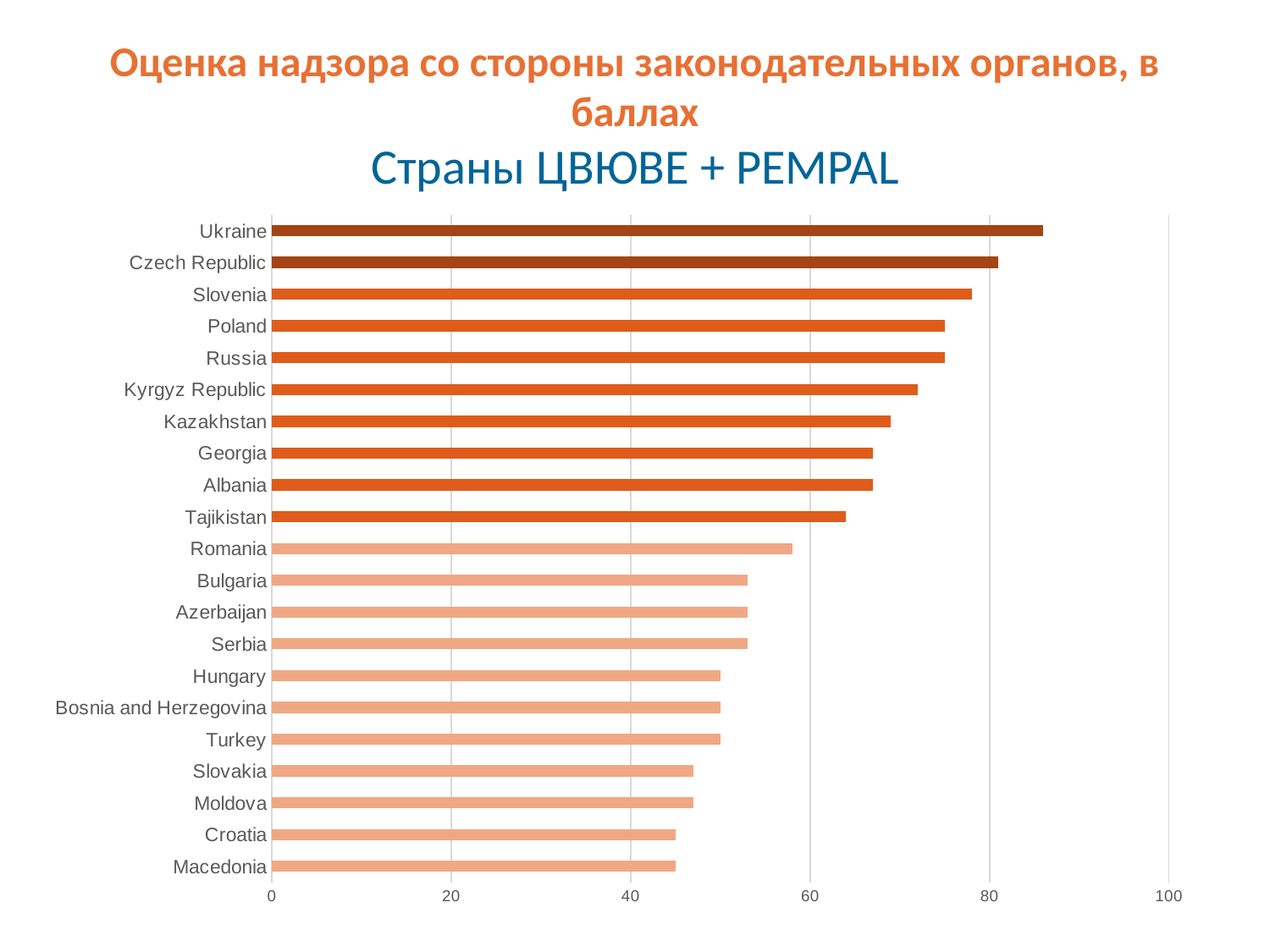
Which has a larger value, Slovenia or Romania? Slovenia Which has a larger value, Ukraine or Czech Republic? Ukraine Is the value for Ukraine greater or less than 80? greater Is the value for Poland greater or less than 80? less Which country has the highest value in the chart? Ukraine How many countries are shown in the chart? 21 What kind of chart is shown on the slide? bar chart Is the value for Tajikistan greater or less than 60? greater Which has a larger value, Tajikistan or Slovakia? Tajikistan What is the maximum value shown on the horizontal axis? 100